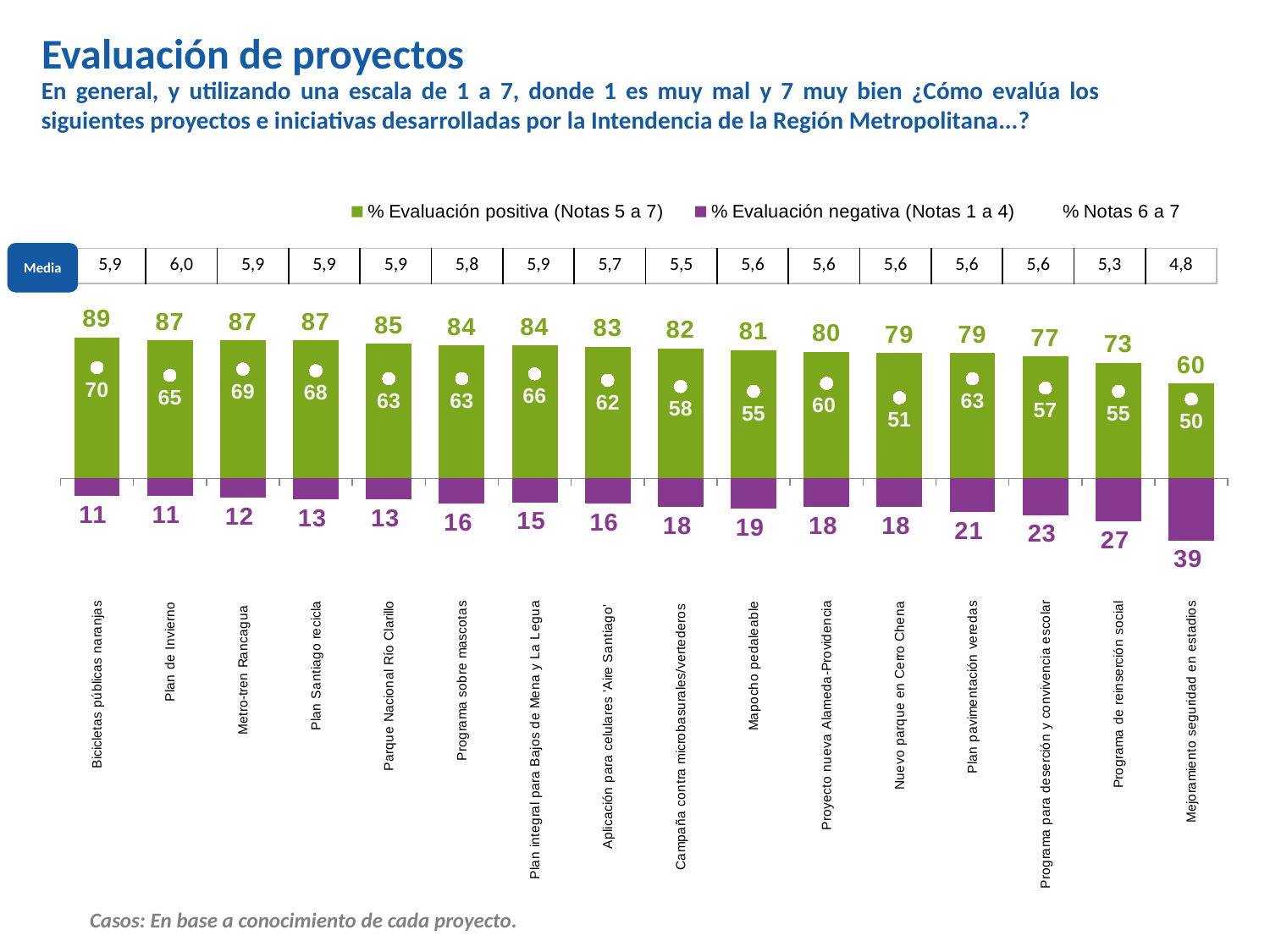
What is the % Evaluación negativa (Notas 1 a 4) value for Mejoramiento seguridad en estadios? 39 Which has a higher % Evaluación negativa (Notas 1 a 4): Programa sobre mascotas or Plan pavimentación veredas? Plan pavimentación veredas How many projects are shown on the chart? 16 What is the Media value shown for Mejoramiento seguridad en estadios? 4,8 What is the % Notas 6 a 7 value for Nuevo parque en Cerro Chena? 51 What is the difference between the % Evaluación positiva values for Plan de Invierno and Programa de reinserción social? 14 What is the % Evaluación positiva (Notas 5 a 7) value for Bicicletas públicas naranjas? 89 What type of chart is shown on the slide? Bar chart How many series does the legend list? 3 Which project has the lowest % Evaluación positiva (Notas 5 a 7)? Mejoramiento seguridad en estadios Do the % Evaluación positiva values rise or fall from left to right across the chart? Fall Which project has the highest % Notas 6 a 7 value? Bicicletas públicas naranjas